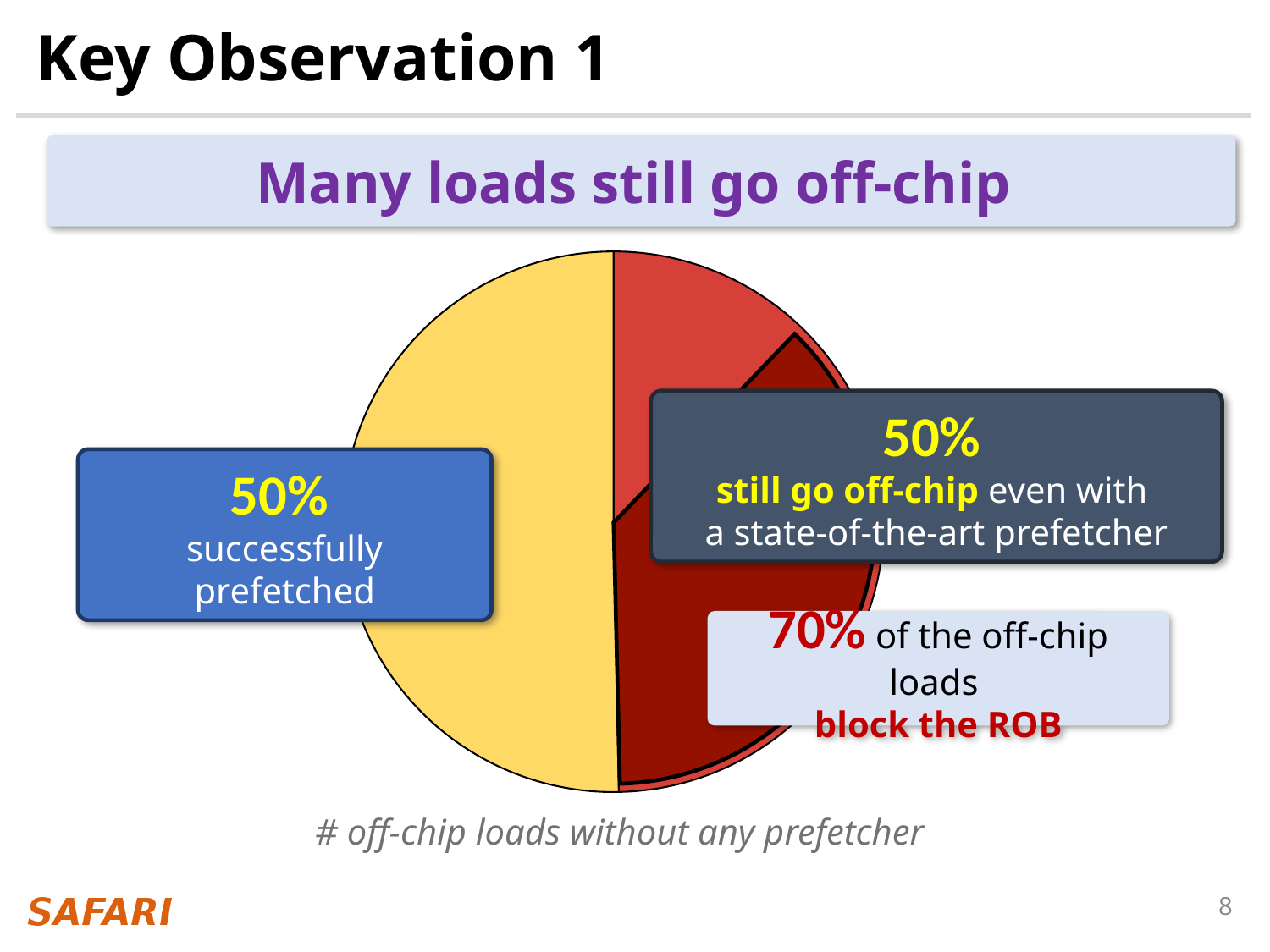
What share of off-chip loads is successfully prefetched according to the pie chart? 50% What colour is the slice representing loads that are successfully prefetched? yellow What kind of chart is shown on the slide? pie chart Which is larger: the share of loads successfully prefetched or the share that still go off-chip? They are equal (50% each) What is the key observation stated in the banner above the pie chart? Many loads still go off-chip Is the share of off-chip loads that block the ROB greater or less than 50%? greater What share of loads still go off-chip even with a state-of-the-art prefetcher? 50% What is the total of the two main slices of the pie chart (successfully prefetched plus still go off-chip)? 100% What does the pie chart represent, according to the caption below it? # off-chip loads without any prefetcher What percentage of the off-chip loads block the ROB? 70% What is the difference between the share successfully prefetched and the share that still go off-chip? 0%